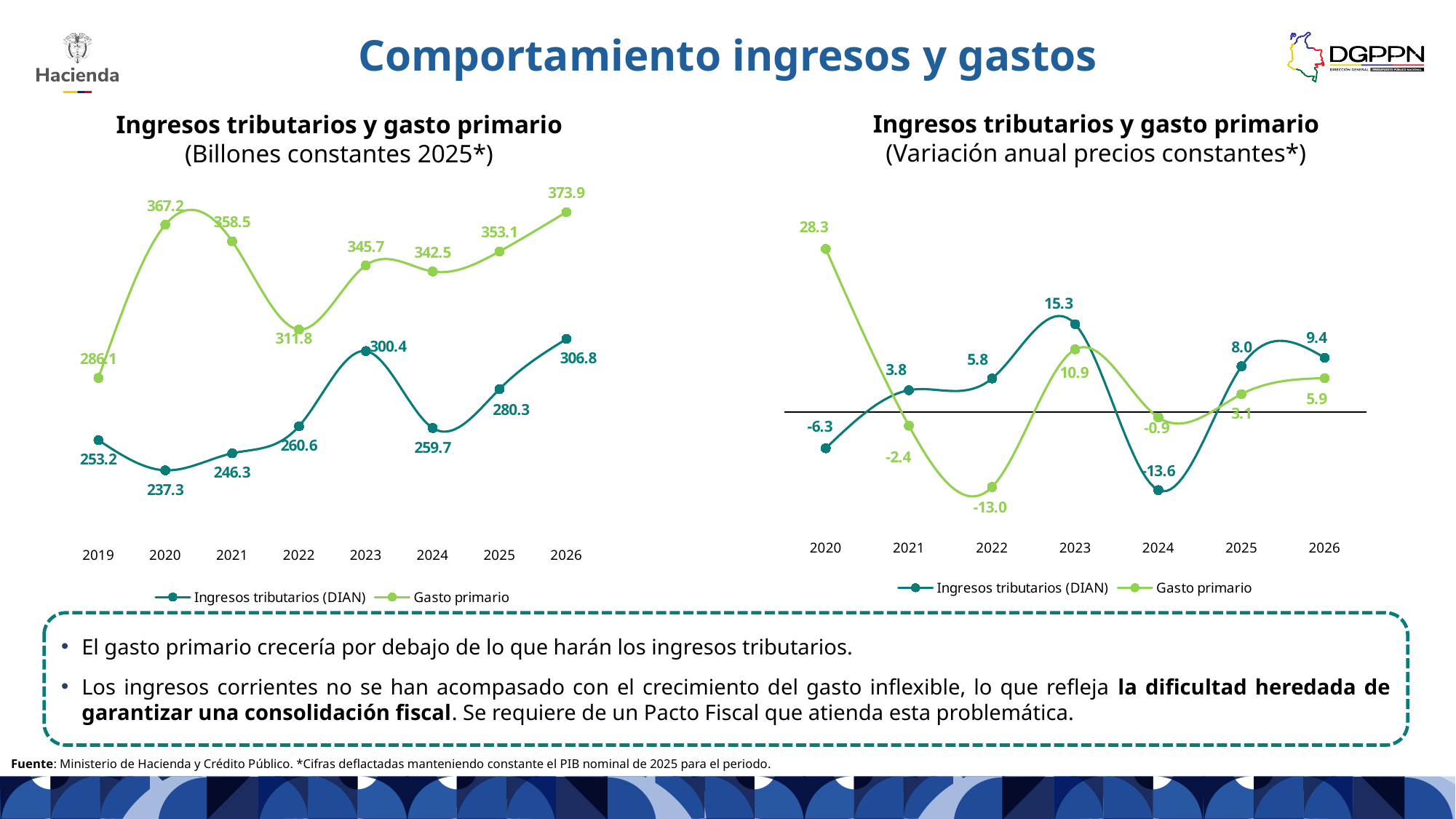
In the right chart (Variación anual precios constantes*), what is the value of Gasto primario in 2022? -13.0 How many series does the legend of the right chart (Variación anual precios constantes*) list? 2 In the left chart (Billones constantes 2025*), in which year is Gasto primario highest? 2026 In the left chart (Billones constantes 2025*), what is the value of Ingresos tributarios (DIAN) in 2026? 306.8 In the right chart (Variación anual precios constantes*), what is the value of Ingresos tributarios (DIAN) in 2023? 15.3 In the right chart (Variación anual precios constantes*), in which year is Ingresos tributarios (DIAN) lowest? 2024 In the left chart (Billones constantes 2025*), in which year is Ingresos tributarios (DIAN) lowest? 2020 In the left chart (Billones constantes 2025*), what is the value of Gasto primario in 2020? 367.2 In the left chart (Billones constantes 2025*), what is the difference between Gasto primario and Ingresos tributarios (DIAN) in 2026? 67.1 In the right chart (Variación anual precios constantes*), which series has the larger value in 2020, Ingresos tributarios (DIAN) or Gasto primario? Gasto primario What type of chart is the left chart (Billones constantes 2025*)? Line chart In the left chart (Billones constantes 2025*), how many years are shown on the x axis? 8